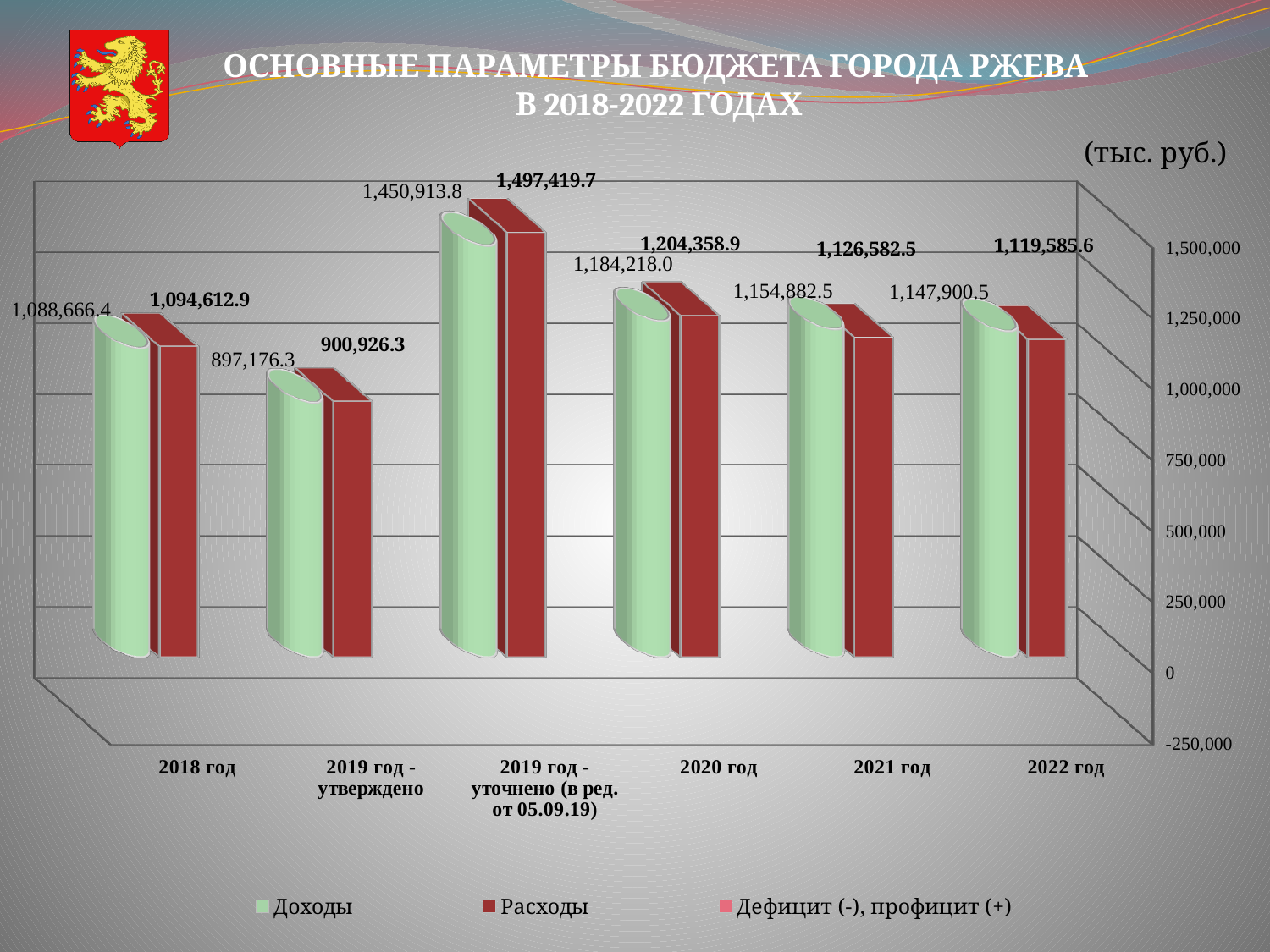
What kind of chart is shown on the slide? Bar chart What is the difference between Доходы and Расходы for 2021 год? 28,300.0 How many series does the legend list? 3 How many categories are shown on the x axis? 6 What is the value of Доходы for 2022 год? 1,147,900.5 What is the difference between Расходы and Доходы for 2019 год - уточнено (в ред. от 05.09.19)? 46,505.9 What is the value of Расходы for 2019 год - уточнено (в ред. от 05.09.19)? 1,497,419.7 What is the value of Доходы for 2018 год? 1,088,666.4 For 2021 год, which is larger: Доходы or Расходы? Доходы What is the value of Расходы for 2020 год? 1,204,358.9 Which category has the lowest value of Расходы? 2019 год - утверждено Which category has the highest value of Доходы? 2019 год - уточнено (в ред. от 05.09.19)